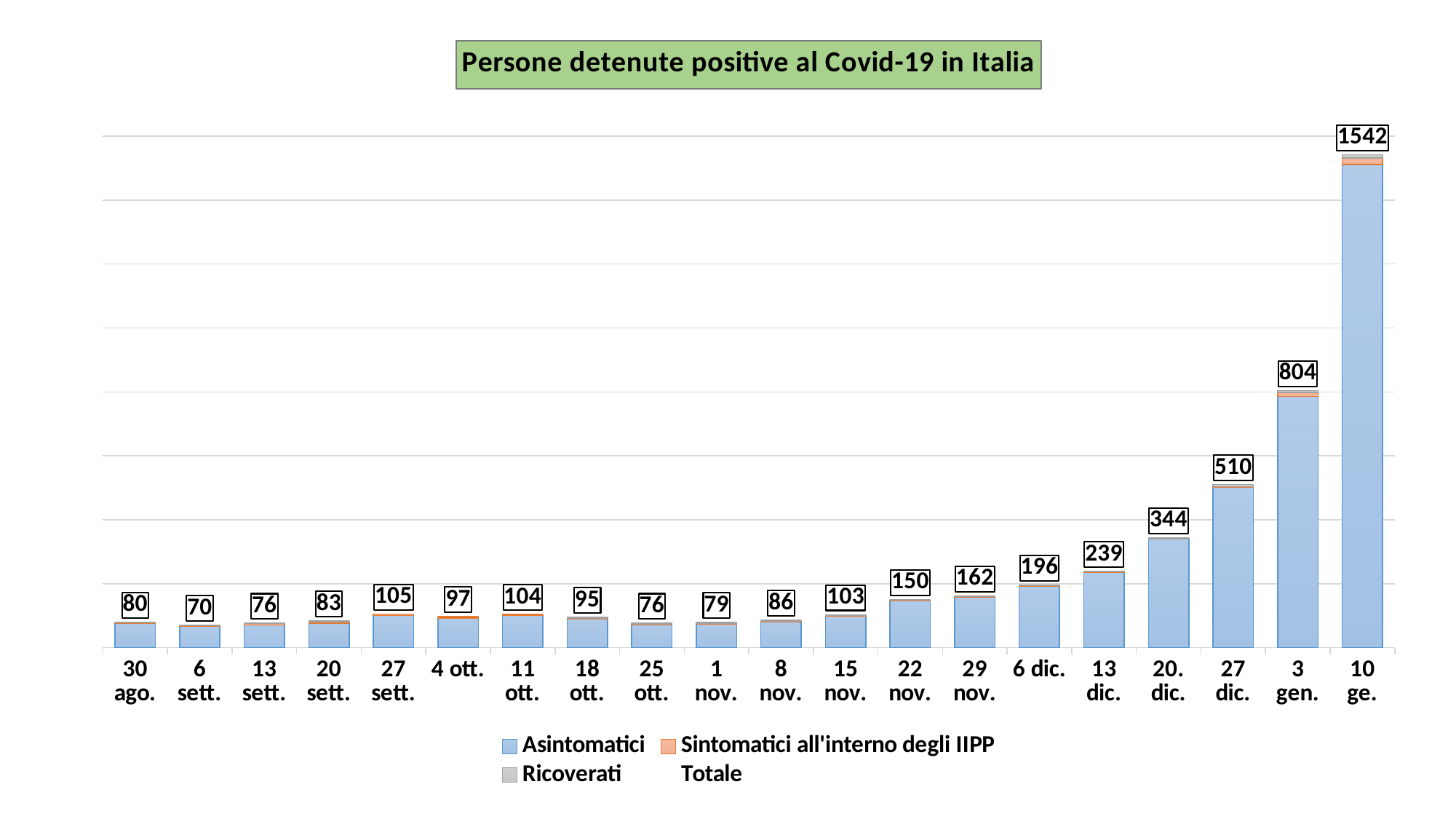
What is the total value labelled for 22 nov.? 150 What is the title of the chart? Persone detenute positive al Covid-19 in Italia How many series does the legend list? 4 Which date has the lowest total? 6 sett. What is the difference between the totals for 27 dic. and 20. dic.? 166 What kind of chart is shown on the slide? Stacked bar chart Which is larger, the total for 27 sett. or the total for 4 ott.? 27 sett. Which date has the highest total? 10 ge. What is the difference between the totals for 10 ge. and 3 gen.? 738 How many dates are shown on the x axis? 20 What is the total number of positive detainees shown for 10 ge.? 1542 What is the total value labelled for 3 gen.? 804